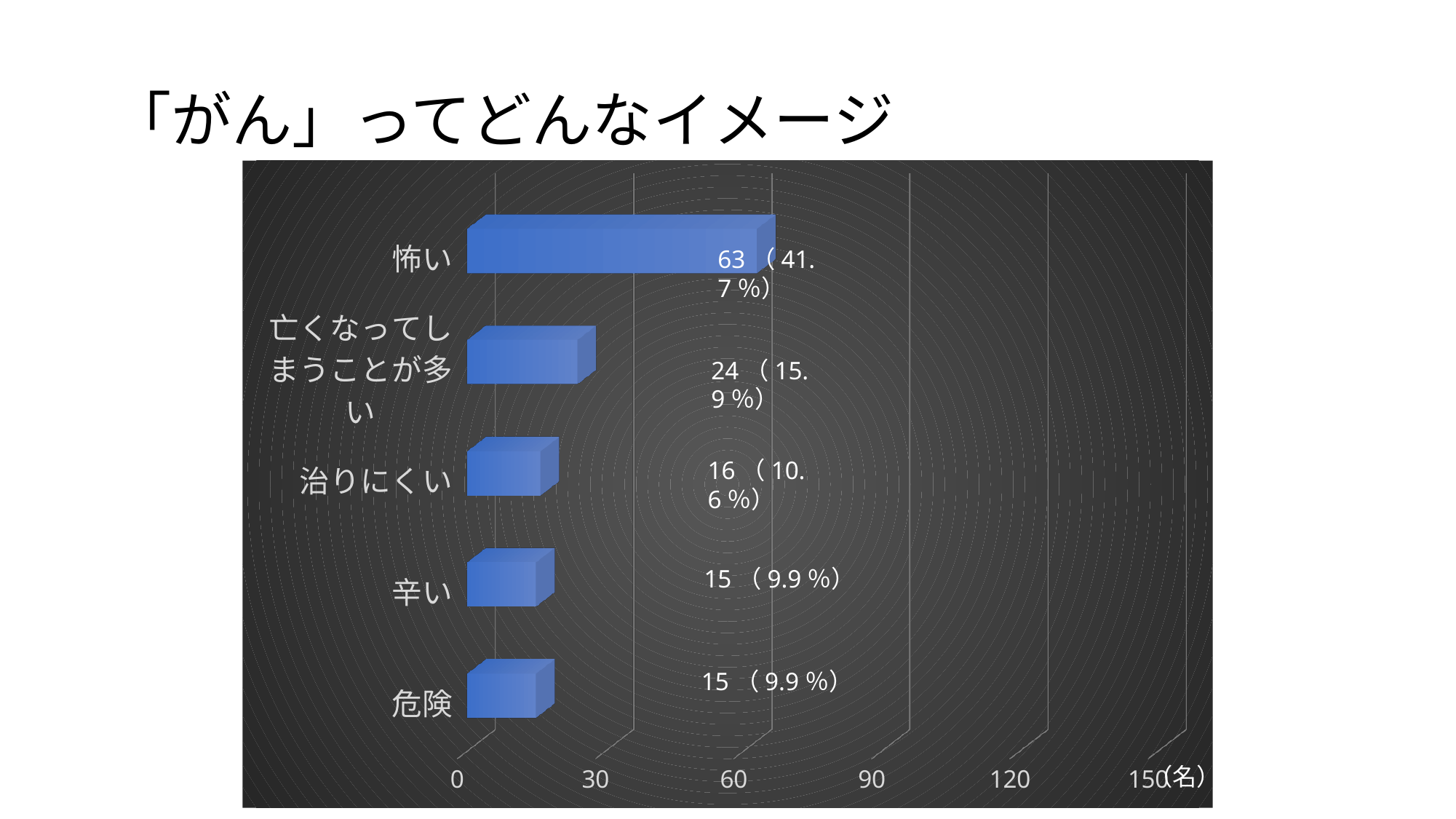
What percentage is shown for 怖い? 41.7% How many categories does the chart show? 5 What is the value for 治りにくい? 16 What is the difference between the values for 怖い and 亡くなってしまうことが多い? 39 What kind of chart is shown on the slide? bar chart What is the value for 怖い? 63 What is the value for 亡くなってしまうことが多い? 24 Which category has the highest value? 怖い Which is larger, the value for 治りにくい or the value for 危険? 治りにくい What is the title of the slide above the chart? 「がん」ってどんなイメージ Is the value for 怖い greater or less than 90? less What percentage is shown for 辛い? 9.9%